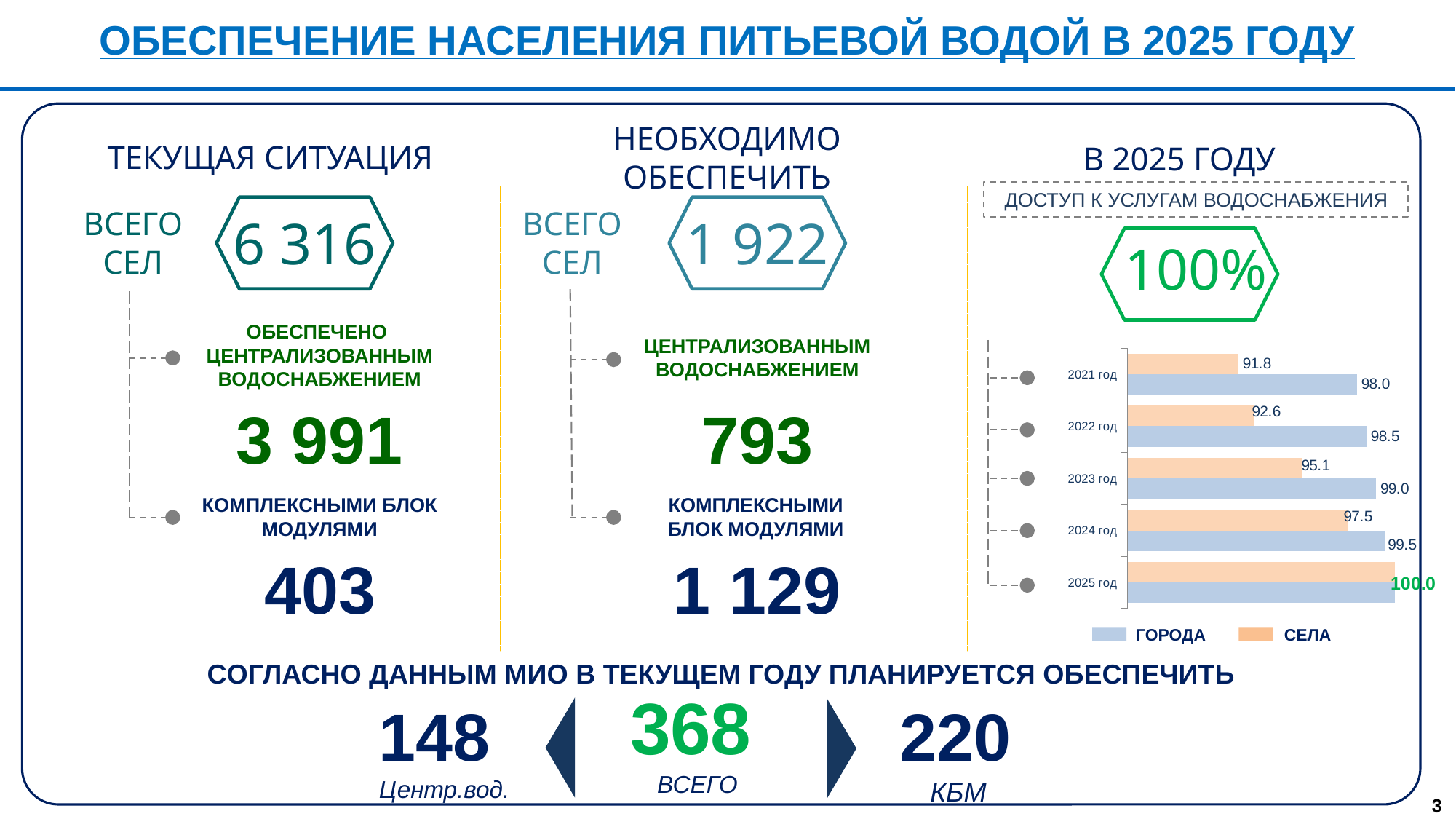
What kind of chart is shown on the slide? bar chart How many series does the chart legend list? 2 Do the values for СЕЛА rise or fall from 2021 год to 2025 год? rise In which year is the value for ГОРОДА the lowest? 2021 год What is the value for ГОРОДА in 2023 год? 99.0 What is the difference between ГОРОДА and СЕЛА in 2022 год? 5.9 Which is larger in 2023 год, ГОРОДА or СЕЛА? ГОРОДА What value is labelled for 2025 год on the chart? 100.0 In which year is the value for СЕЛА the lowest? 2021 год How many years are shown on the chart? 5 What is the value for СЕЛА in 2024 год? 97.5 What is the value for СЕЛА in 2021 год? 91.8